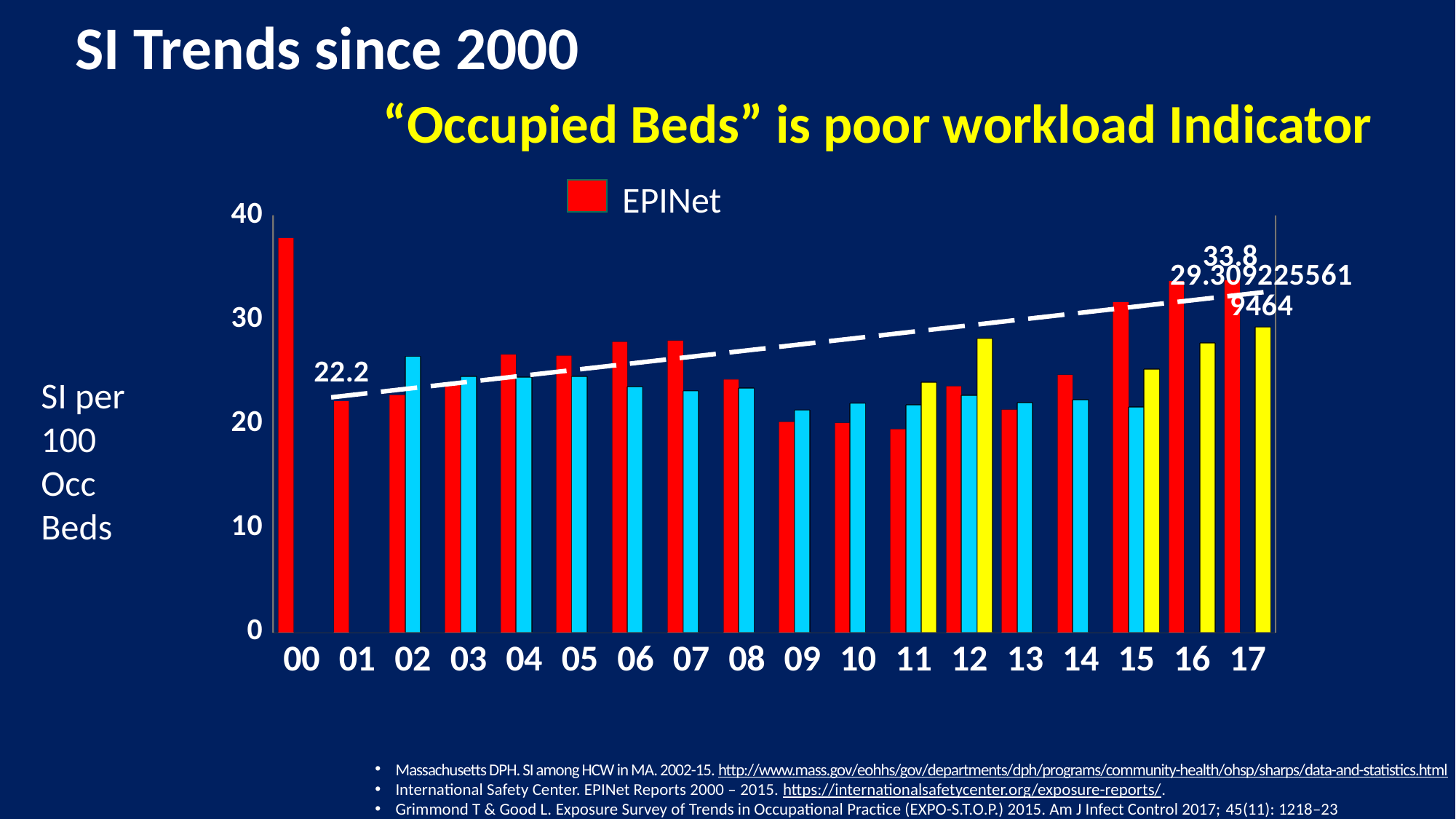
What series name is shown in the chart legend? EPINet What is the EPINet (red) value for year 01? 22.2 Which is larger, the red bar for year 14 or the red bar for year 15? 15 How many years are shown along the x axis? 18 Which year has the highest red (EPINet) bar? 00 What kind of chart is shown on the slide? bar chart How many series does the legend list? 1 Is the red (EPINet) value for year 15 greater or less than 30? greater Which is larger, the red bar for year 00 or the red bar for year 01? 00 Does the dashed trend line rise or fall from left to right? rise Is the yellow bar for year 12 greater or less than 20? greater Is the red (EPINet) value for year 00 greater or less than 30? greater